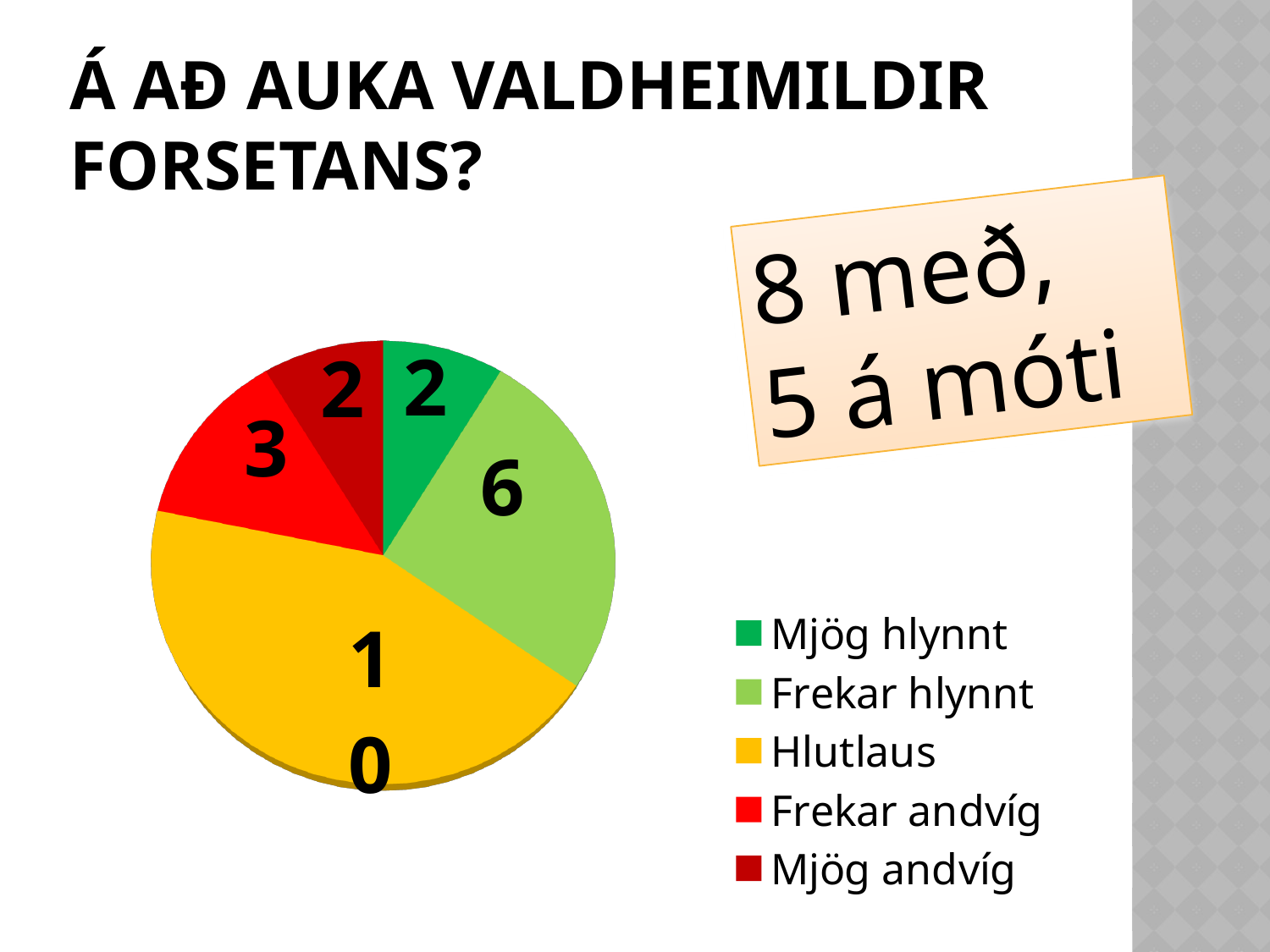
Which category has the largest slice of the pie? Hlutlaus How many categories does the legend list? 5 What is the value for Frekar hlynnt? 6 What is the total of all the slices in the pie chart? 23 Which is larger, the value for Frekar hlynnt or the value for Frekar andvíg? Frekar hlynnt What type of chart is shown on the slide? pie chart What colour is the Hlutlaus slice? yellow What is the difference between the values for Hlutlaus and Frekar hlynnt? 4 What is the value for Hlutlaus? 10 What is the value for Mjög hlynnt? 2 What is the difference between the values for Frekar andvíg and Mjög andvíg? 1 What is the value for Frekar andvíg? 3